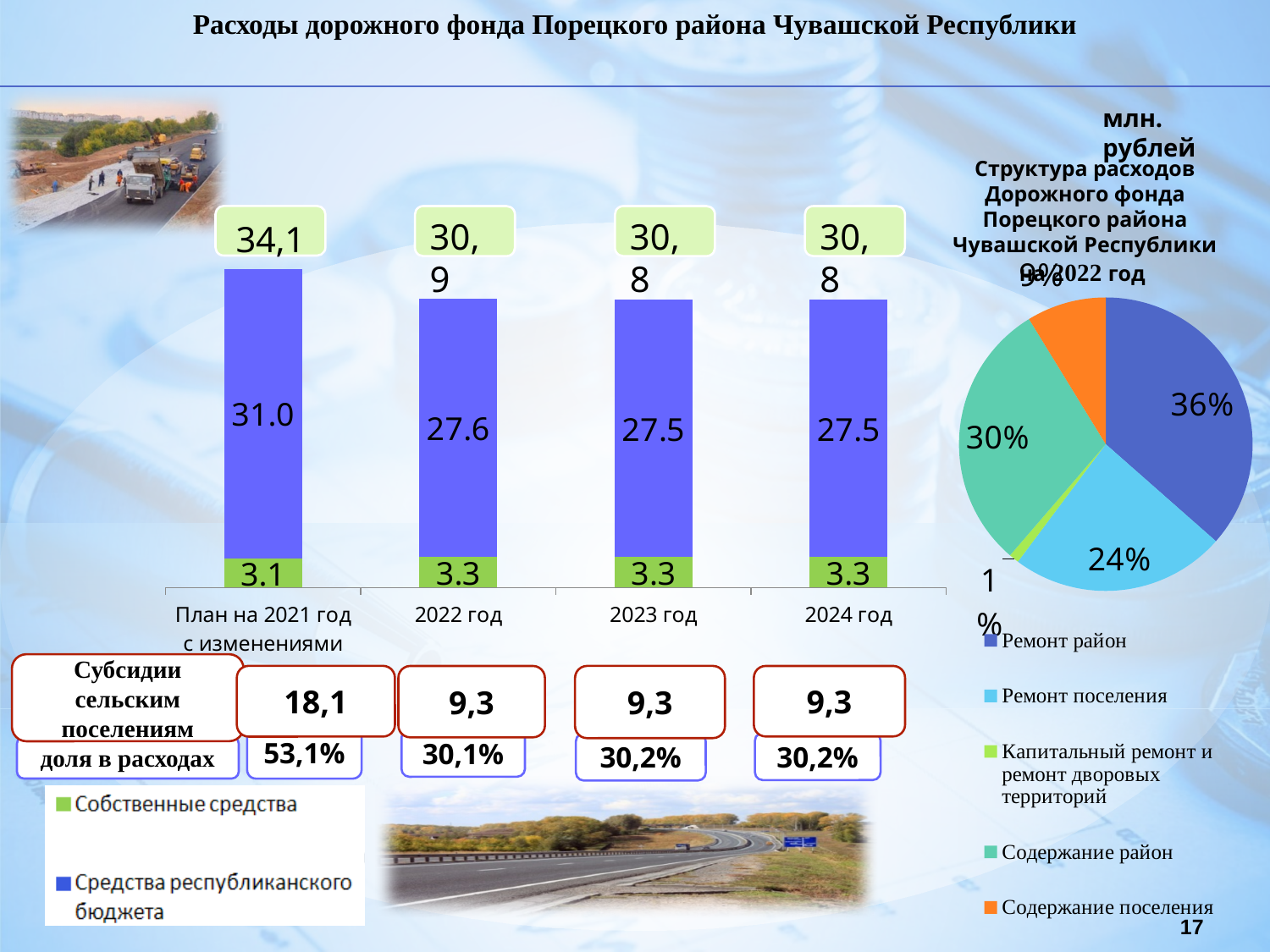
On the pie chart Структура расходов Дорожного фонда Порецкого района Чувашской Республики на 2022 год, which category has the smallest share? Капитальный ремонт и ремонт дворовых территорий On the bar chart, how many series does the legend list? 2 On the bar chart, what is the total shown above the bar for План на 2021 год с изменениями? 34,1 On the pie chart Структура расходов Дорожного фонда Порецкого района Чувашской Республики на 2022 год, what share does Ремонт район have? 36% On the pie chart Структура расходов Дорожного фонда Порецкого района Чувашской Республики на 2022 год, which is larger: Ремонт поселения or Содержание район? Содержание район On the bar chart, what is the value of Собственные средства for 2022 год? 3.3 What kind of chart is the chart on the left of the slide? Stacked bar chart On the bar chart, what is the value of Средства республиканского бюджета for План на 2021 год с изменениями? 31.0 On the bar chart, which category has the highest value for Средства республиканского бюджета? План на 2021 год с изменениями On the bar chart, what is the value of Средства республиканского бюджета for 2023 год? 27.5 On the bar chart, how many categories are shown on the x axis? 4 On the bar chart, what is the difference between Средства республиканского бюджета for План на 2021 год с изменениями and for 2022 год? 3.4